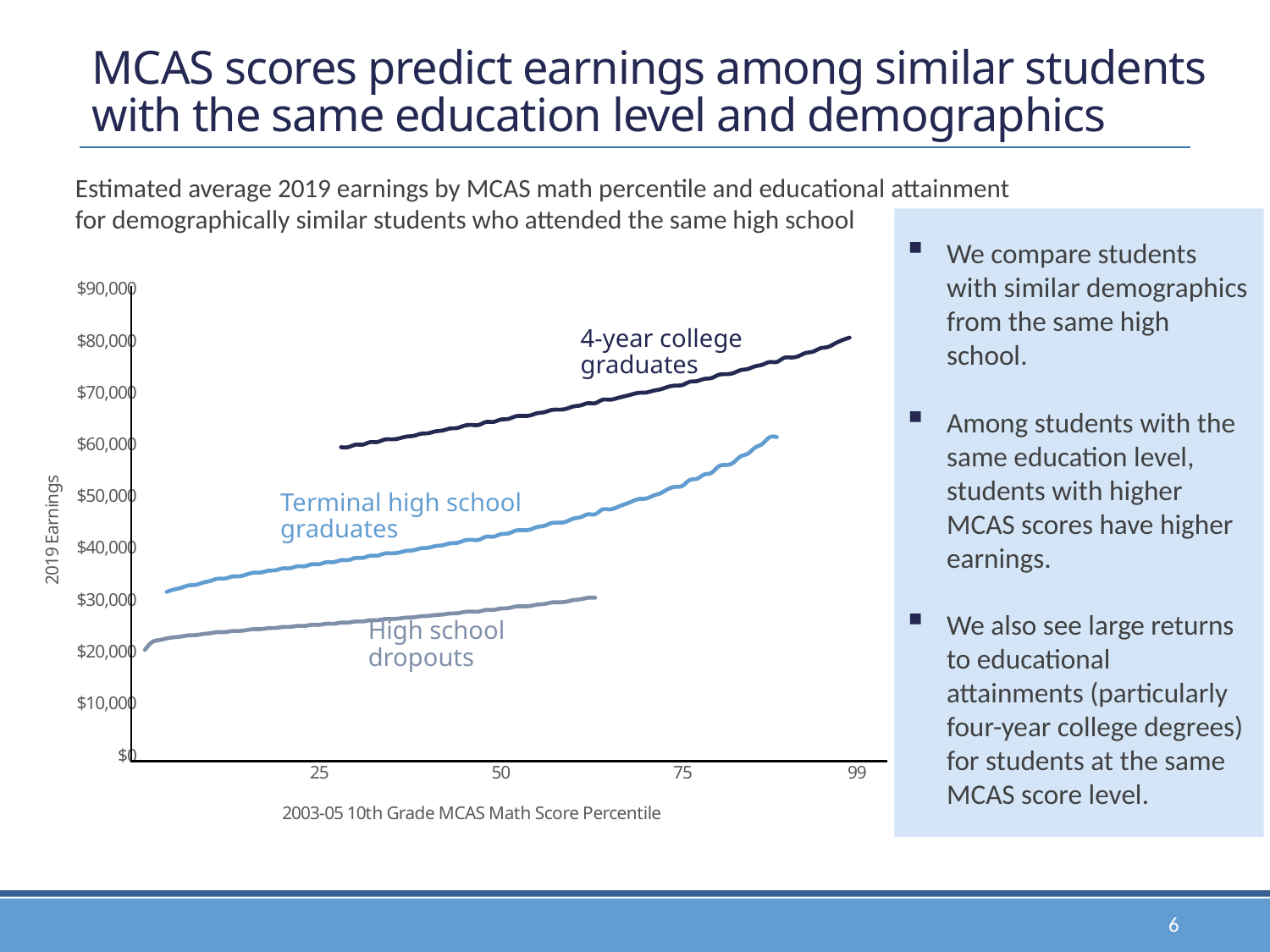
At the 50th MCAS math percentile, is the value for 4-year college graduates greater or less than $60,000? greater At the 50th MCAS math percentile, is the value for high school dropouts greater or less than $30,000? less How many educational attainment groups are plotted as lines on the chart? 3 Which educational attainment group has the highest estimated 2019 earnings across the chart? 4-year college graduates At the 25th MCAS math percentile, is the value for terminal high school graduates greater or less than $40,000? less Which educational attainment group has the lowest estimated 2019 earnings across the chart? High school dropouts Do estimated earnings rise or fall as the MCAS math score percentile increases? rise What is the title of the vertical axis? 2019 Earnings At the 75th MCAS math percentile, which group has higher earnings: 4-year college graduates or terminal high school graduates? 4-year college graduates What is the title of the horizontal axis? 2003-05 10th Grade MCAS Math Score Percentile What kind of chart is shown on the slide? line chart